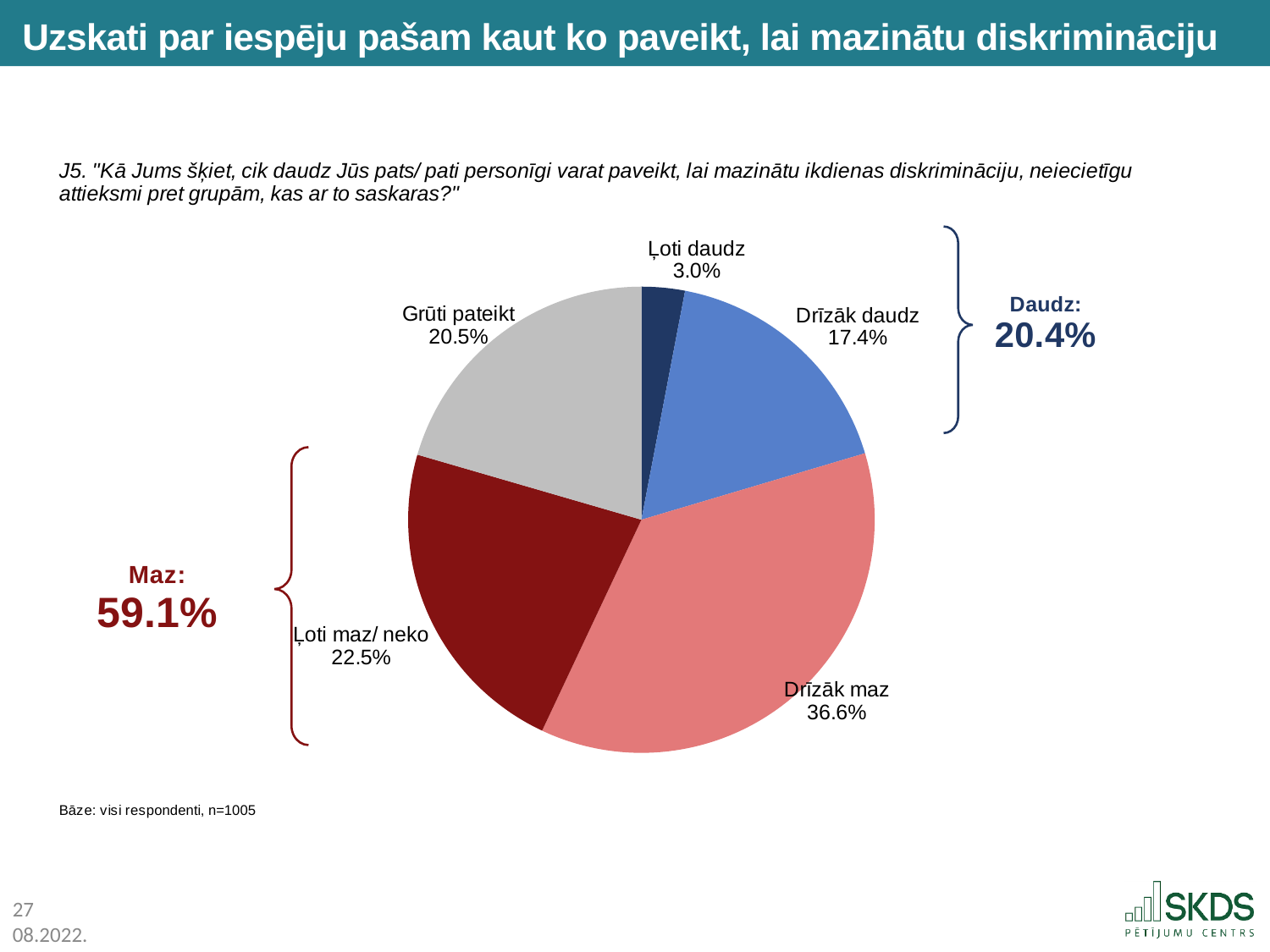
What kind of chart is shown on the slide? pie chart What share of respondents answered "Grūti pateikt"? 20.5% What share of respondents answered "Ļoti daudz"? 3.0% What share of respondents answered "Ļoti maz/ neko"? 22.5% How many slices does the pie chart have? 5 Which is larger, the share for "Ļoti maz/ neko" or the share for "Grūti pateikt"? Ļoti maz/ neko What combined percentage is shown for the "Daudz" group? 20.4% What share of respondents answered "Drīzāk maz"? 36.6% What combined percentage is shown for the "Maz" group? 59.1% Which response has the smallest slice of the pie? Ļoti daudz What is the difference in percentage points between "Drīzāk maz" and "Drīzāk daudz"? 19.2 Which response has the largest slice of the pie? Drīzāk maz